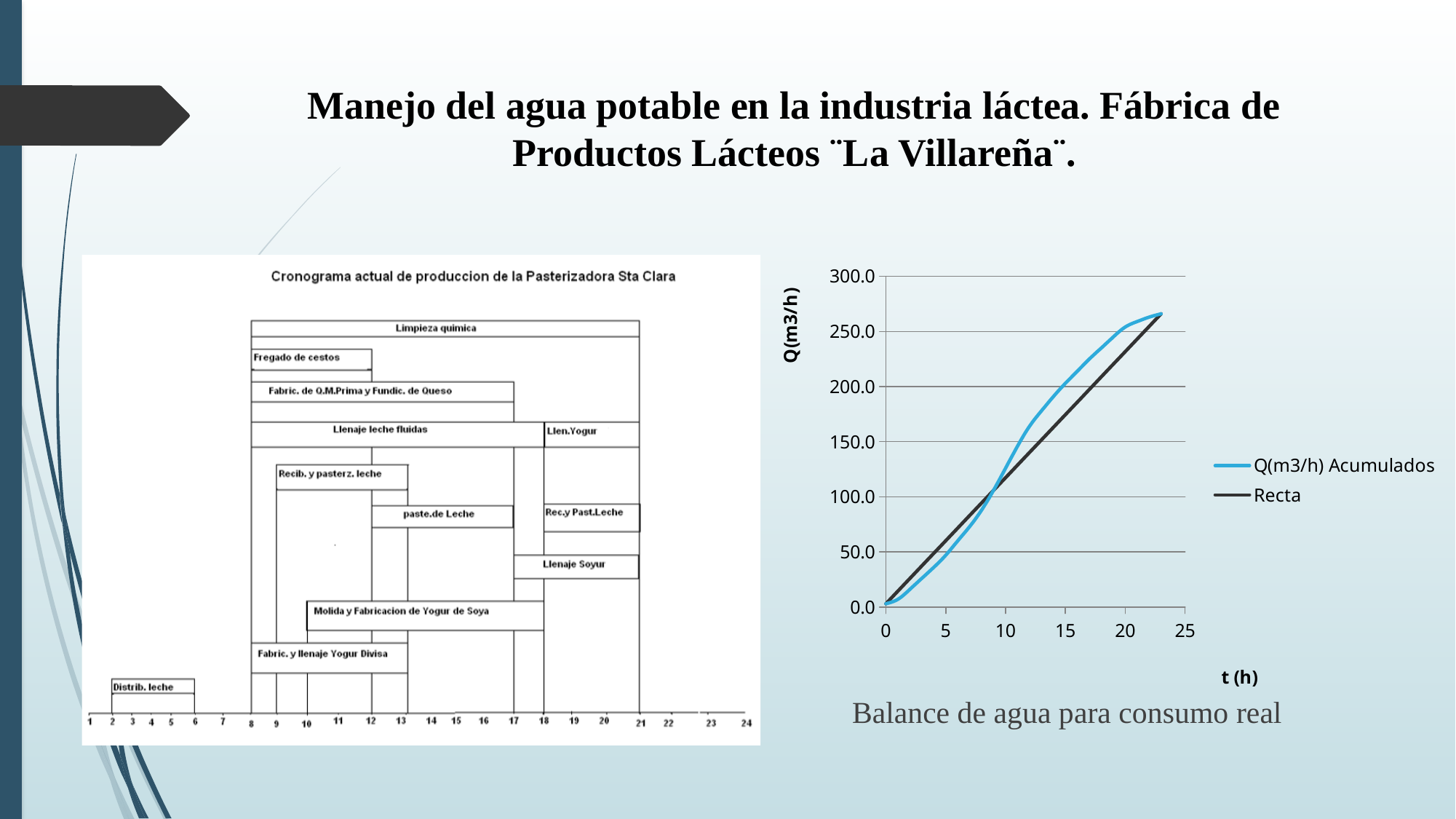
What kind of chart is the chart on the right of the slide (Balance de agua para consumo real)? line chart In the right-hand line chart, is the value of Recta at t = 20 greater or less than 250? less What is the title of the chart on the left of the slide? Cronograma actual de produccion de la Pasterizadora Sta Clara In the right-hand line chart, at t = 15, which series has the higher value, Q(m3/h) Acumulados or Recta? Q(m3/h) Acumulados In the right-hand line chart, is the value of Q(m3/h) Acumulados at t = 15 greater or less than 150? greater In the right-hand line chart, is the value of Q(m3/h) Acumulados at t = 10 greater or less than 100? greater In the right-hand line chart, does the Recta series rise or fall along the x axis? rise What is the label of the y axis of the right-hand line chart? Q(m3/h) In the right-hand line chart, does the Q(m3/h) Acumulados series rise or fall as t (h) increases? rise How many series does the legend of the right-hand line chart list? 2